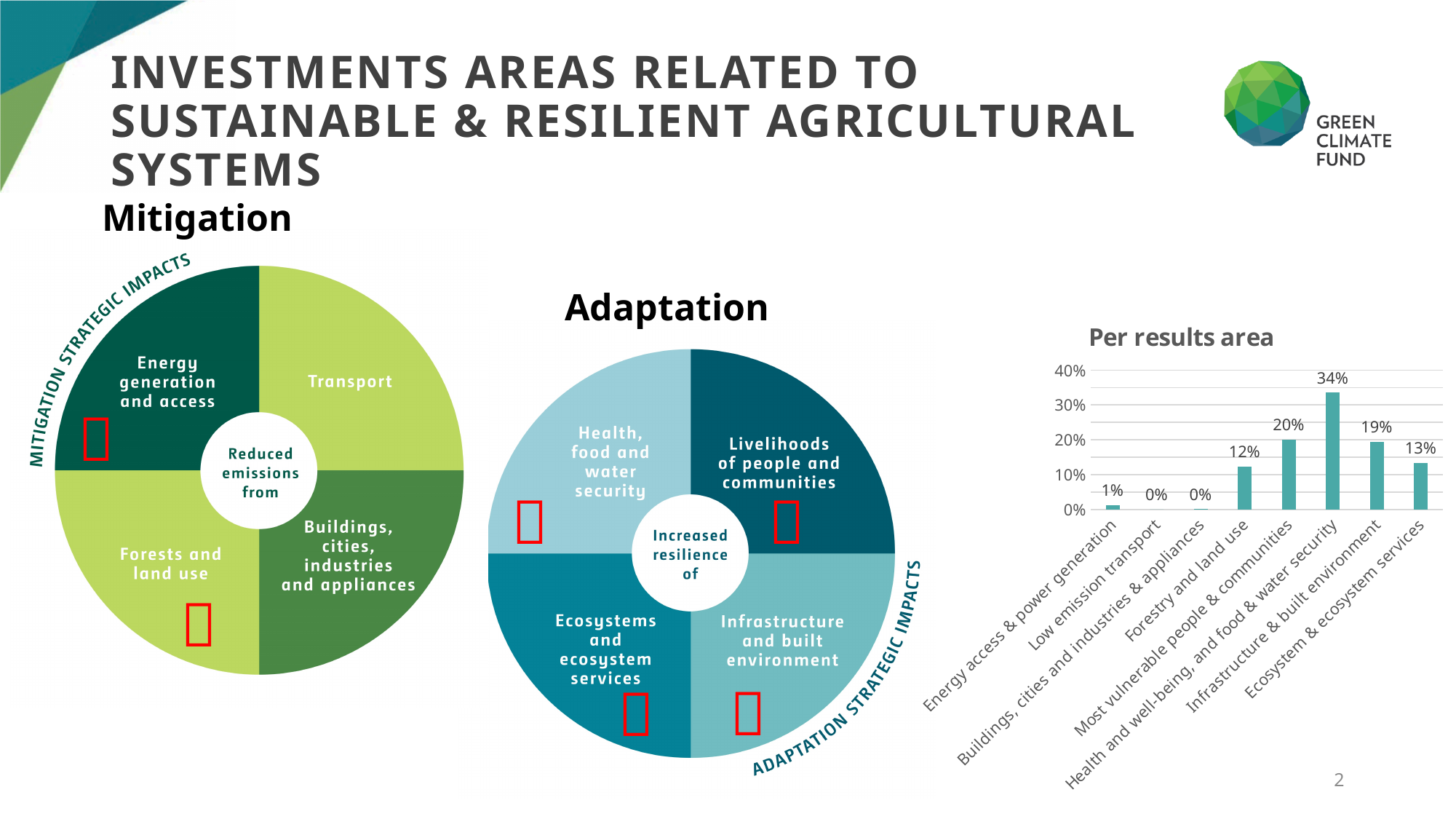
In the 'Per results area' chart, which is larger: Infrastructure & built environment or Ecosystem & ecosystem services? Infrastructure & built environment What kind of chart is the 'Per results area' chart? Bar chart In the 'Per results area' chart, what is the value for Forestry and land use? 12% In the 'Per results area' chart, what is the value for Health and well-being, and food & water security? 34% In the 'Per results area' chart, what is the value for Infrastructure & built environment? 19% In the 'Per results area' chart, what is the value for Ecosystem & ecosystem services? 13% What is the title of the bar chart on the right of the slide? Per results area How many results areas are shown in the 'Per results area' chart? 8 In the 'Per results area' chart, what is the value for Energy access & power generation? 1% In the 'Per results area' chart, what is the difference between Most vulnerable people & communities and Forestry and land use? 8% In the 'Per results area' chart, which results area has the highest value? Health and well-being, and food & water security In the 'Per results area' chart, is the value for Most vulnerable people & communities greater or less than 10%? greater